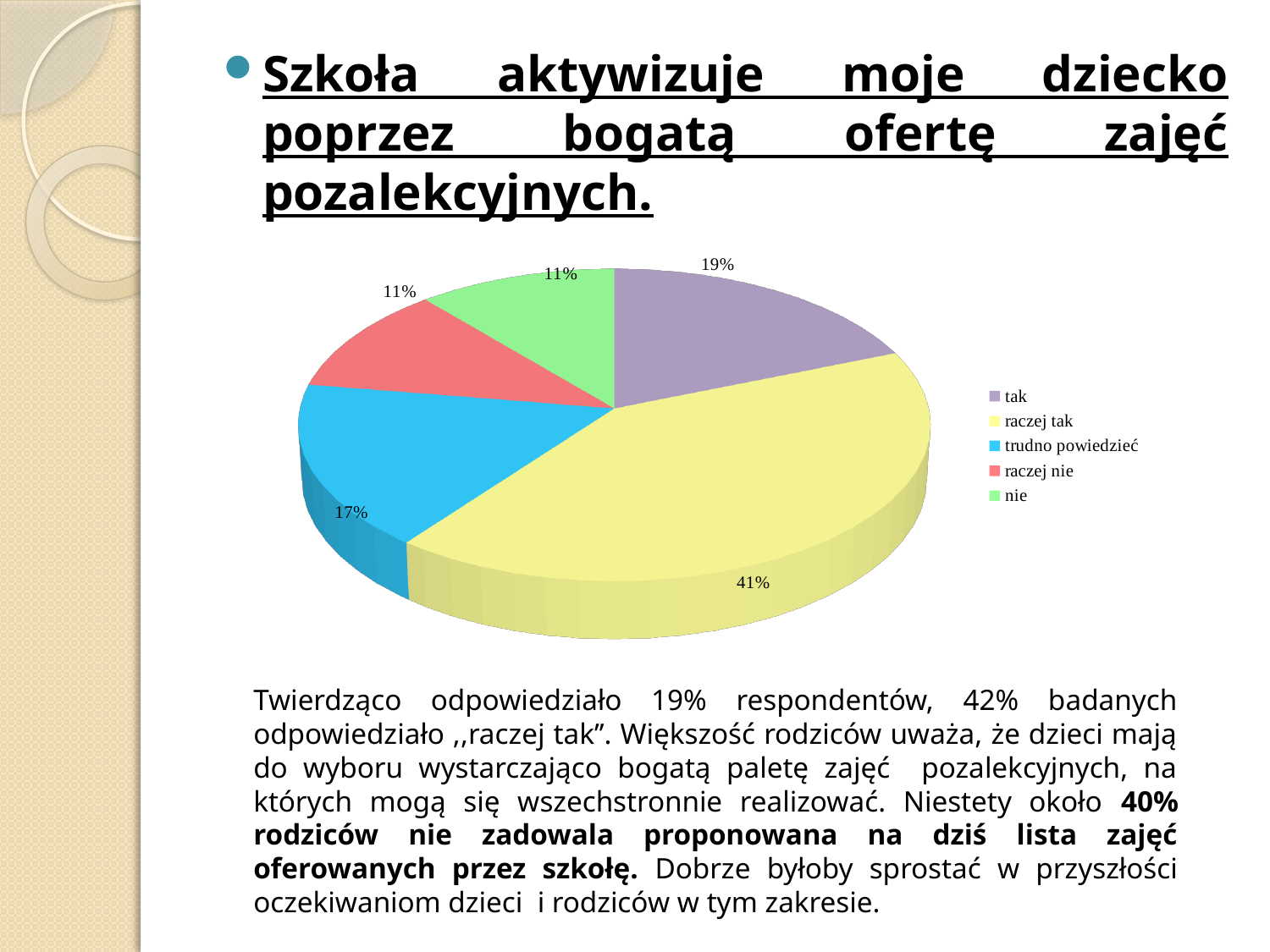
What percentage of the pie is labelled "raczej tak"? 41% How many entries does the legend list? 5 Which category has the largest slice of the pie? raczej tak How many slices does the pie chart have? 5 Which slice is larger, "tak" or "trudno powiedzieć"? tak What percentage of the pie is labelled "tak"? 19% What colour is the "raczej tak" slice in the pie chart? yellow What percentage of the pie is labelled "trudno powiedzieć"? 17% What kind of chart is shown on the slide? pie chart What percentage of the pie is labelled "nie"? 11% What percentage of the pie is labelled "raczej nie"? 11% What is the difference in percentage points between the "raczej tak" slice and the "tak" slice? 22